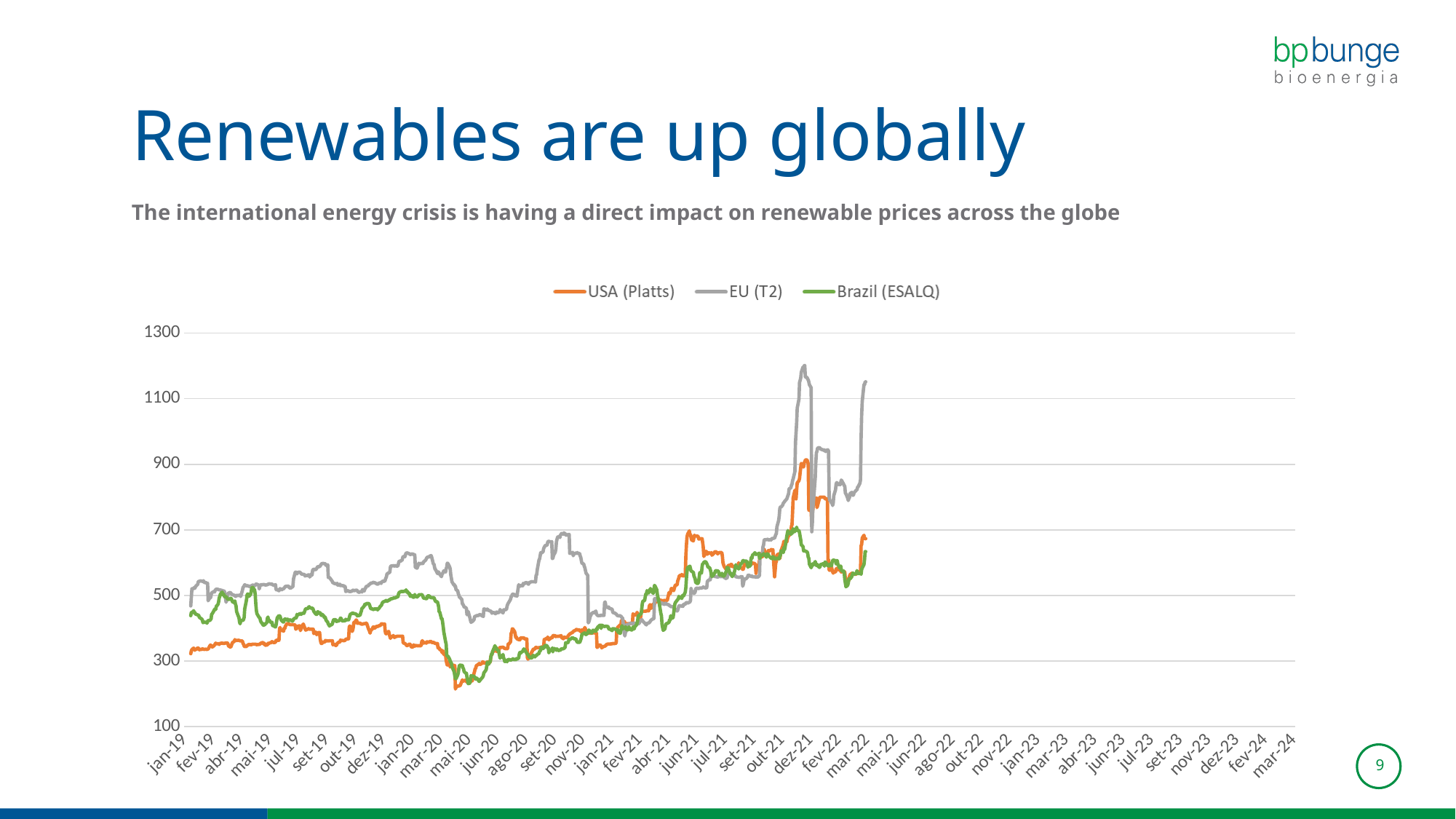
Is the peak value of the USA (Platts) line around dez-21 greater or less than 700? greater Does the USA (Platts) line overall rise or fall from jan-19 to mar-22? rise What kind of chart is shown on the slide? line chart Is the peak value of the EU (T2) line around dez-21 greater or less than 1100? greater How many series does the chart legend list? 3 What colour is the EU (T2) line in the chart? grey Which series are listed in the chart legend? USA (Platts), EU (T2), Brazil (ESALQ) At jan-19, which series has the lowest value? USA (Platts) Is the value of the USA (Platts) line at jan-19 greater or less than 300? greater Which series reaches the highest value anywhere on the chart? EU (T2)